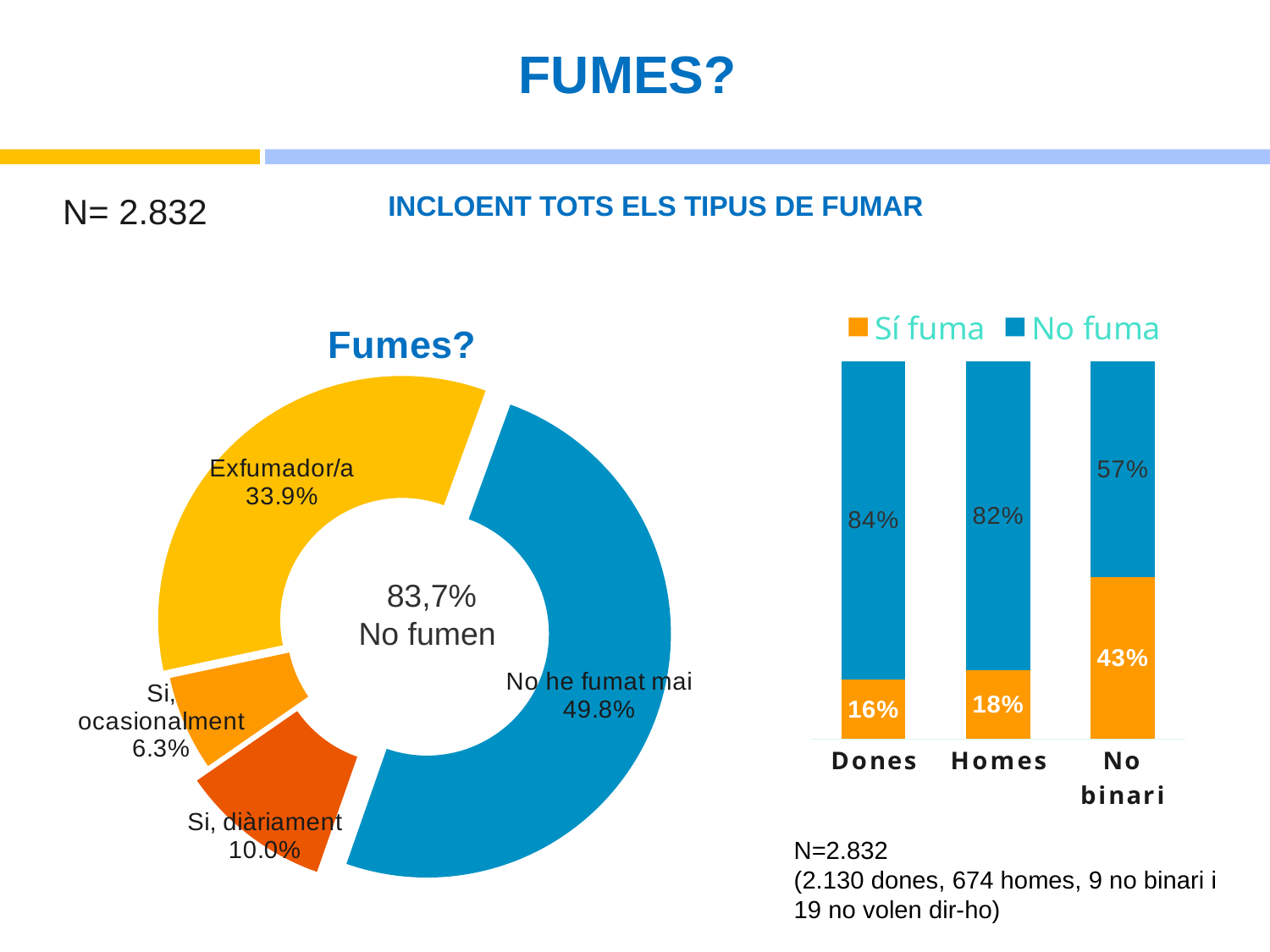
In the stacked bar chart on the right, what is the 'No fuma' value for 'Dones'? 84% In the 'Fumes?' doughnut chart, what share is labelled for 'Si, diàriament'? 10.0% In the 'Fumes?' doughnut chart, how many categories are shown? 4 In the 'Fumes?' doughnut chart, what share is labelled for 'Exfumador/a'? 33.9% In the stacked bar chart on the right, what is the 'Sí fuma' value for 'No binari'? 43% In the stacked bar chart on the right, which category has the highest 'Sí fuma' value? No binari In the 'Fumes?' doughnut chart, what text is shown in the centre of the ring? 83,7% No fumen In the stacked bar chart on the right, what is the difference between the 'Sí fuma' values for 'Homes' and 'Dones'? 2% In the 'Fumes?' doughnut chart, which category has the largest share? No he fumat mai In the 'Fumes?' doughnut chart, which category has the smallest share? Si, ocasionalment In the stacked bar chart on the right, how many series does the legend list? 2 In the 'Fumes?' doughnut chart, what share is labelled for 'No he fumat mai'? 49.8%